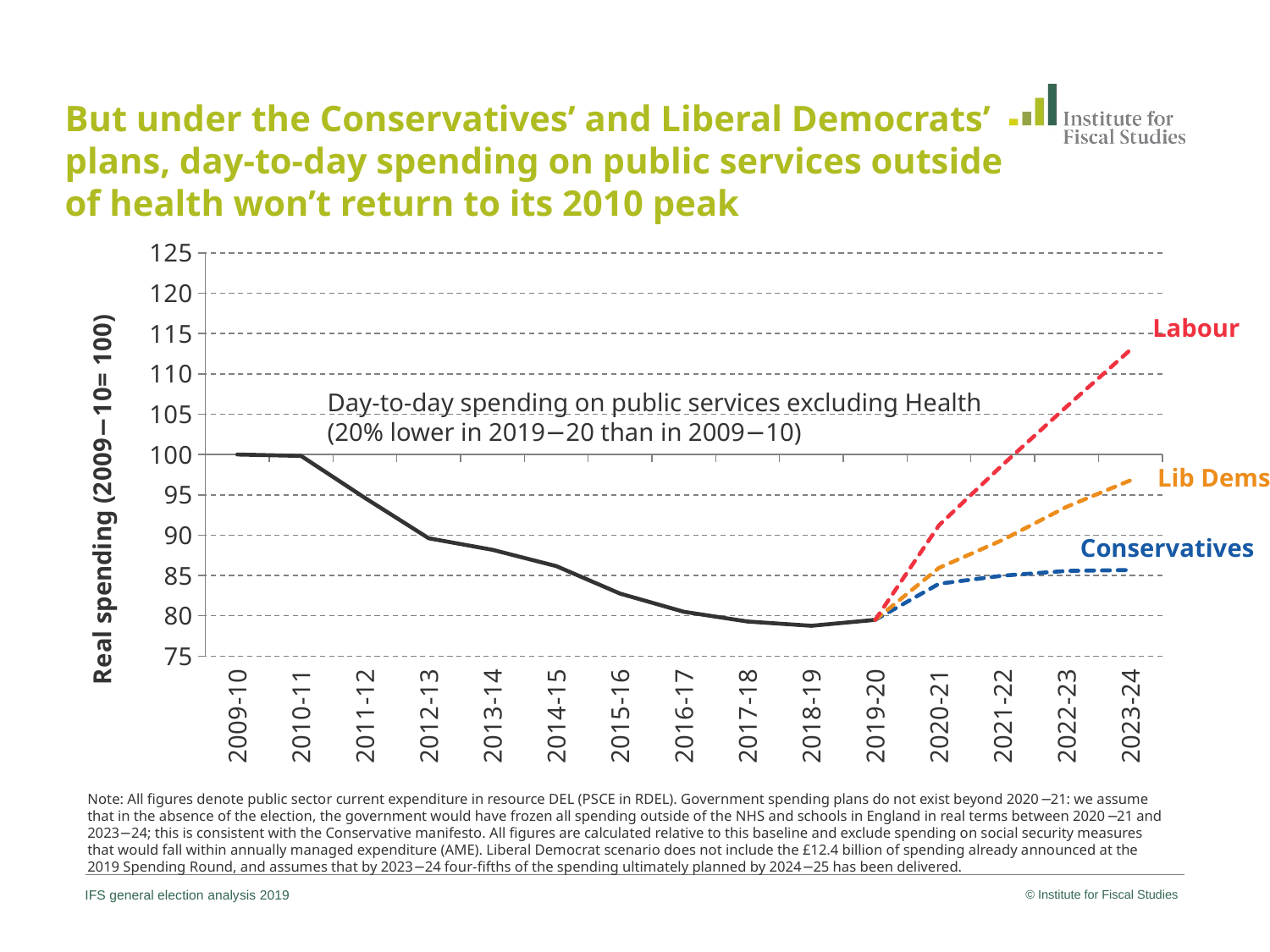
What kind of chart is shown on the slide? line chart Is the value for 2018-19 greater or less than 85? less Does real spending rise or fall between 2010-11 and 2018-19? fall Which party's plan gives the lowest spending in 2023-24? Conservatives What is the value of real spending in 2009-10? 100 In 2023-24, which is larger: the Lib Dems value or the Conservatives value? Lib Dems Is the Conservatives value for 2023-24 greater or less than 90? less Is the Labour value for 2023-24 greater or less than 110? greater What is the label on the y axis of the chart? Real spending (2009−10 = 100) How many years are shown on the x axis of the chart? 15 Which party's plan gives the highest spending in 2023-24? Labour